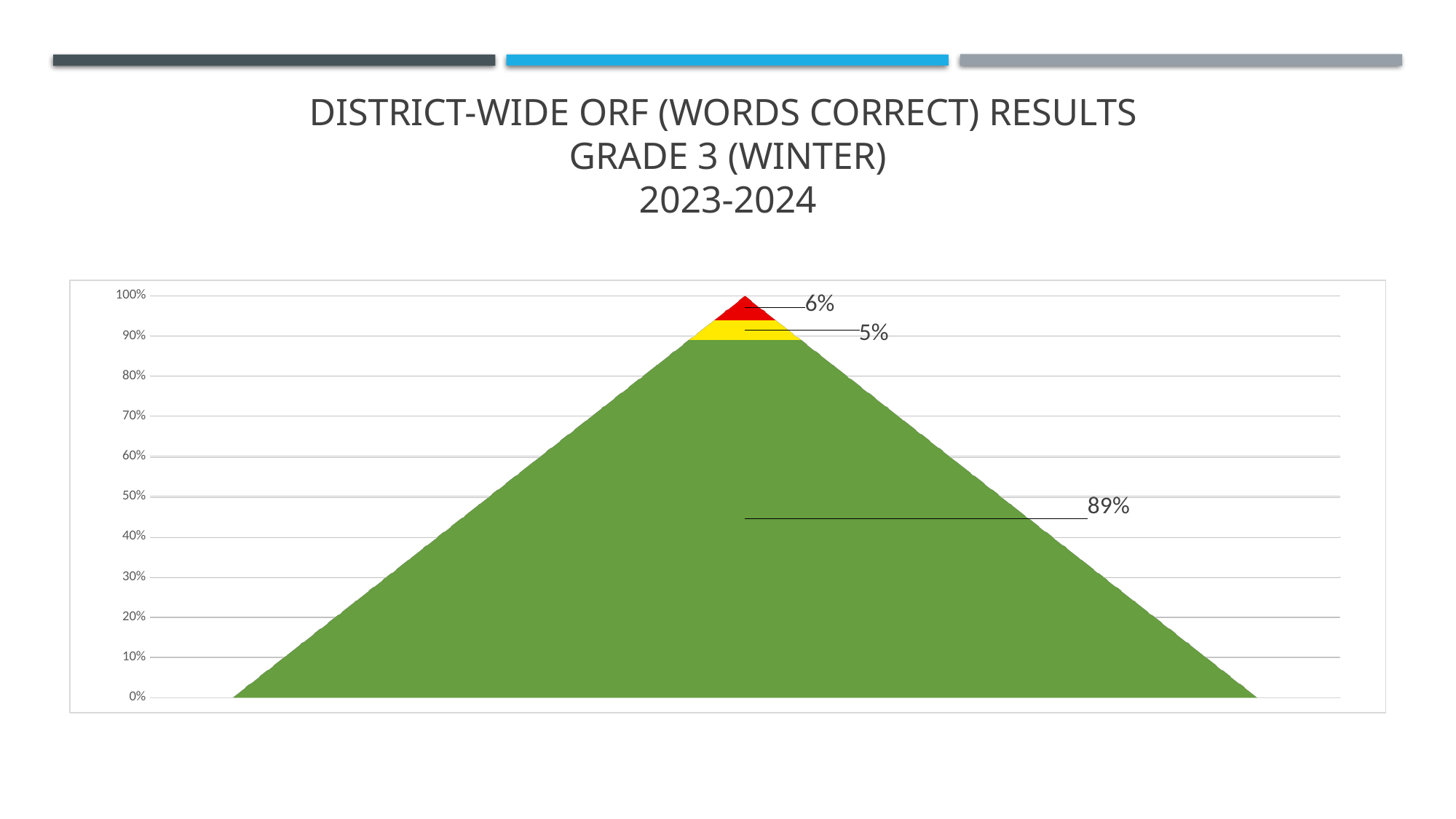
What is the difference between the green segment's value and the red segment's value? 83% What value is shown for the green segment of the chart? 89% What value is shown for the red segment at the top of the chart? 6% What is the title of the chart on the slide? DISTRICT-WIDE ORF (WORDS CORRECT) RESULTS GRADE 3 (WINTER) 2023-2024 Is the value for the green segment greater or less than 80%? greater Which is larger, the red segment or the yellow segment? Red Which coloured segment has the largest value? Green Which coloured segment has the smallest value? Yellow What value is shown for the yellow segment of the chart? 5% What is the total of the three labelled segments in the chart? 100% How many coloured segments are labelled with values in the chart? 3 What is the difference between the red segment's value and the yellow segment's value? 1%